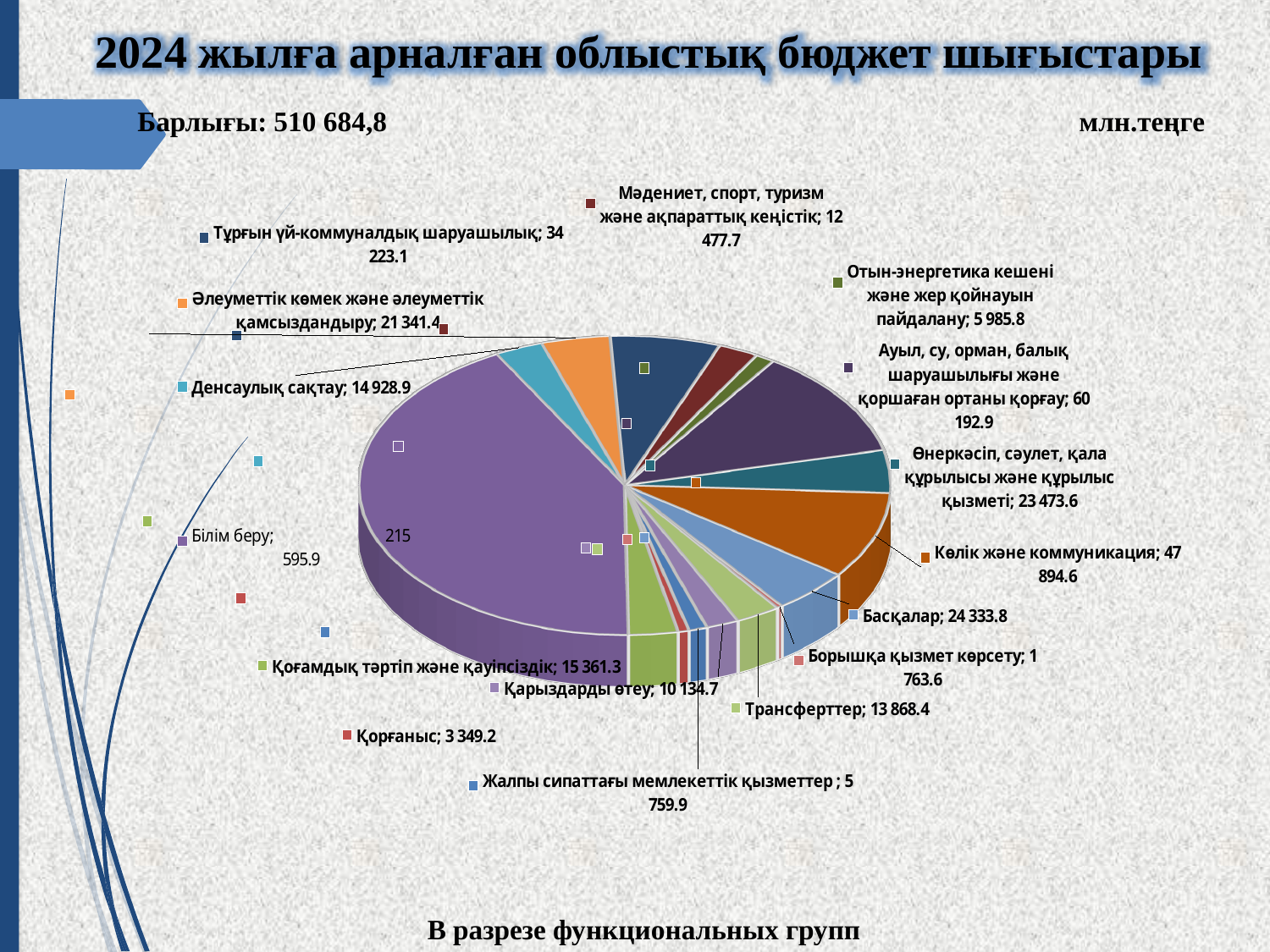
What unit is stated for the values on the slide? млн.теңге What is the value for Білім беру? 215 595.9 What is the value for Денсаулық сақтау? 14 928.9 What is the difference between Ауыл, су, орман, балық шаруашылығы және қоршаған ортаны қорғау and Көлік және коммуникация? 12 298.3 What total amount (Барлығы) is stated on the slide? 510 684,8 What is the value for Көлік және коммуникация? 47 894.6 What kind of chart is shown on the slide? Pie chart What is the value for Қорғаныс? 3 349.2 How many categories does the pie chart have? 16 Which category has the smallest value? Борышқа қызмет көрсету Which category has the largest value? Білім беру Which is larger: Тұрғын үй-коммуналдық шаруашылық or Көлік және коммуникация? Көлік және коммуникация